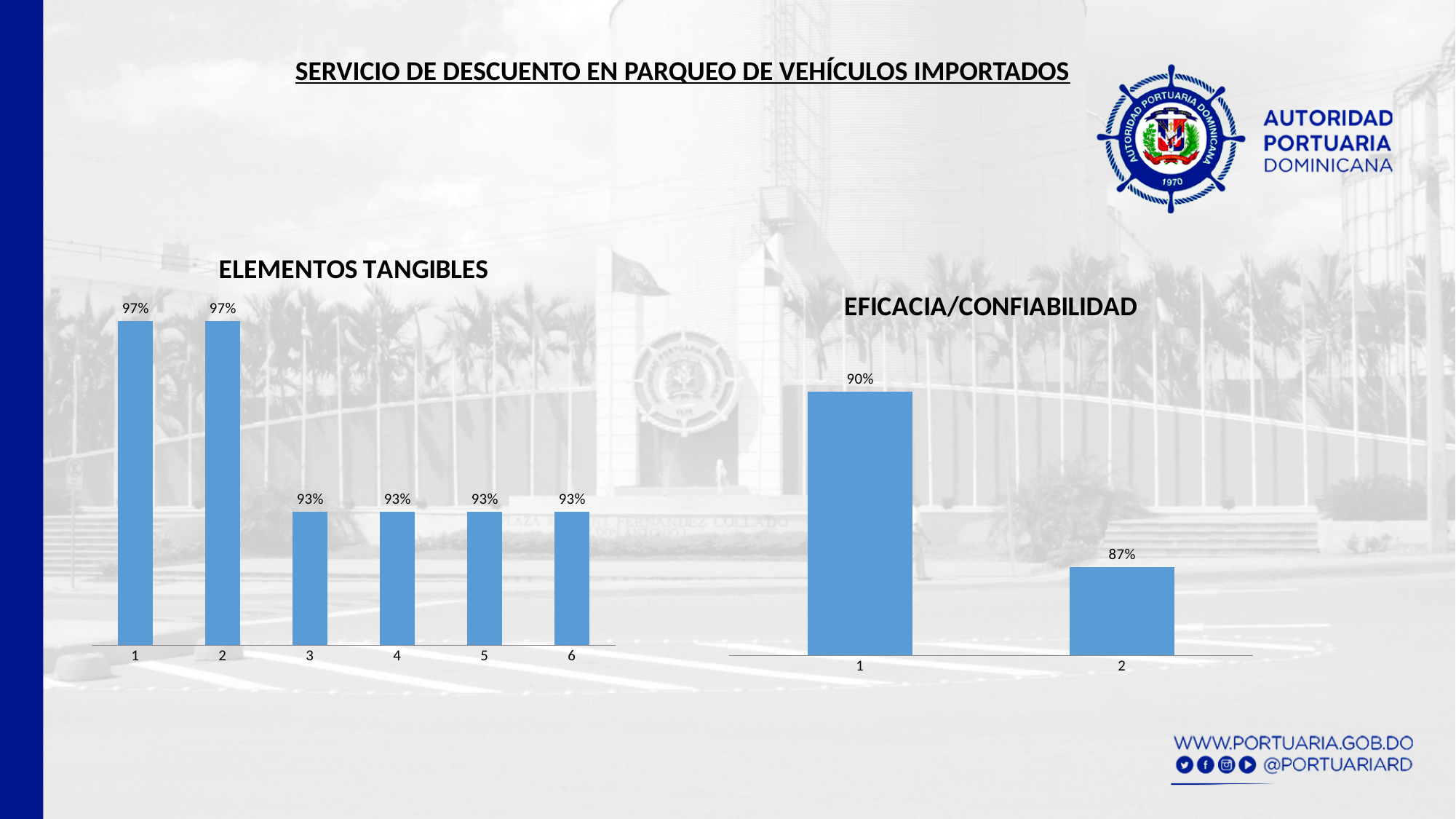
What is the title of the chart on the right side of the slide? EFICACIA/CONFIABILIDAD In the EFICACIA/CONFIABILIDAD chart, which category has the lowest value? 2 How many categories are shown in the ELEMENTOS TANGIBLES chart? 6 In the ELEMENTOS TANGIBLES chart, what is the difference between the values for category 2 and category 3? 4% In the ELEMENTOS TANGIBLES chart, what is the value for category 4? 93% In the ELEMENTOS TANGIBLES chart, which is larger, the value for category 2 or the value for category 5? Category 2 In the EFICACIA/CONFIABILIDAD chart, what is the value for category 2? 87% In the EFICACIA/CONFIABILIDAD chart, what is the difference between the values for category 1 and category 2? 3% In the EFICACIA/CONFIABILIDAD chart, which category has the highest value? 1 How many categories are shown in the EFICACIA/CONFIABILIDAD chart? 2 What kind of chart is the ELEMENTOS TANGIBLES chart? Bar chart In the ELEMENTOS TANGIBLES chart, what is the value for category 1? 97%